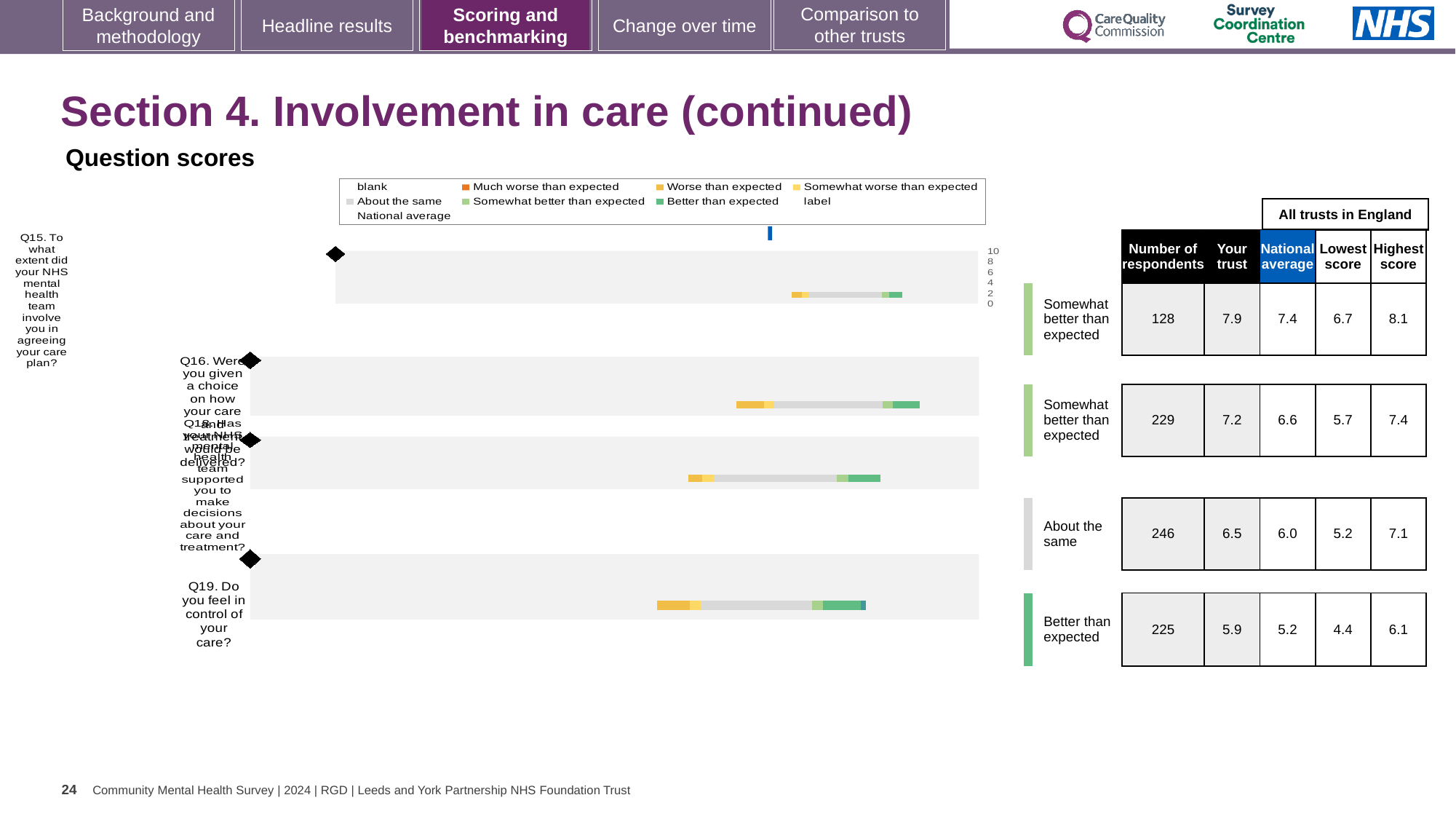
Which is larger for Q16: the 'Your trust' score or the national average? Your trust What benchmark category is shown for Q19 in the question scores chart? Better than expected In the table beside the chart, what is the highest score among all trusts in England for Q19 (feeling in control of your care)? 6.1 Which question has the lowest 'Your trust' score in the table beside the chart? Q19 In the table beside the chart, how many respondents answered Q18 (supported to make decisions about care and treatment)? 246 What is the difference between the 'Your trust' score and the national average for Q18? 0.5 How many questions (bars) are plotted in the question scores chart? 4 Which question has the highest 'Your trust' score in the table beside the chart? Q15 What kind of chart is used to show the question scores on this slide? bar chart In the table beside the chart, what is the national average for Q16 (choice on how care and treatment would be delivered)? 6.6 What benchmark category is shown for Q18 in the question scores chart? About the same In the table beside the chart, what is the 'Your trust' score for Q15 (involvement in agreeing your care plan)? 7.9